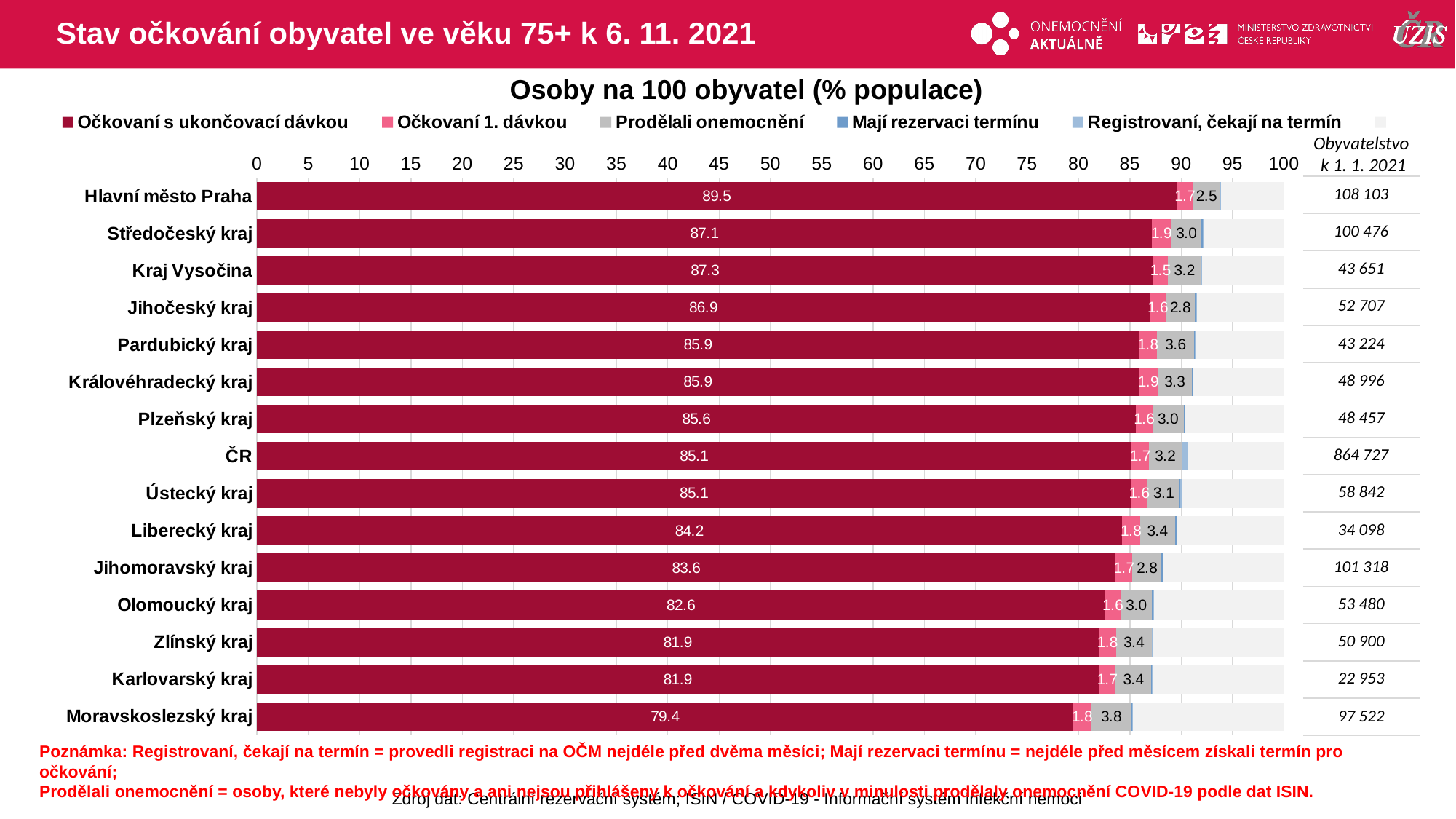
What kind of chart is shown on the slide? bar chart Which category has the lowest value for 'Očkovaní s ukončovací dávkou'? Moravskoslezský kraj How many categories (rows) are plotted in the chart? 15 What is the value of 'Očkovaní s ukončovací dávkou' for ČR? 85.1 What is the value of 'Očkovaní 1. dávkou' for Středočeský kraj? 1.9 Which category has the highest value for 'Očkovaní s ukončovací dávkou'? Hlavní město Praha Is the 'Očkovaní s ukončovací dávkou' value for Moravskoslezský kraj greater or less than 80? less Which has a larger 'Prodělali onemocnění' value, Pardubický kraj or Jihočeský kraj? Pardubický kraj What is the value of 'Prodělali onemocnění' for Moravskoslezský kraj? 3.8 What is the title of the chart? Osoby na 100 obyvatel (% populace) What is the difference in 'Očkovaní s ukončovací dávkou' between Hlavní město Praha and Moravskoslezský kraj? 10.1 What is the value of 'Očkovaní s ukončovací dávkou' for Hlavní město Praha? 89.5